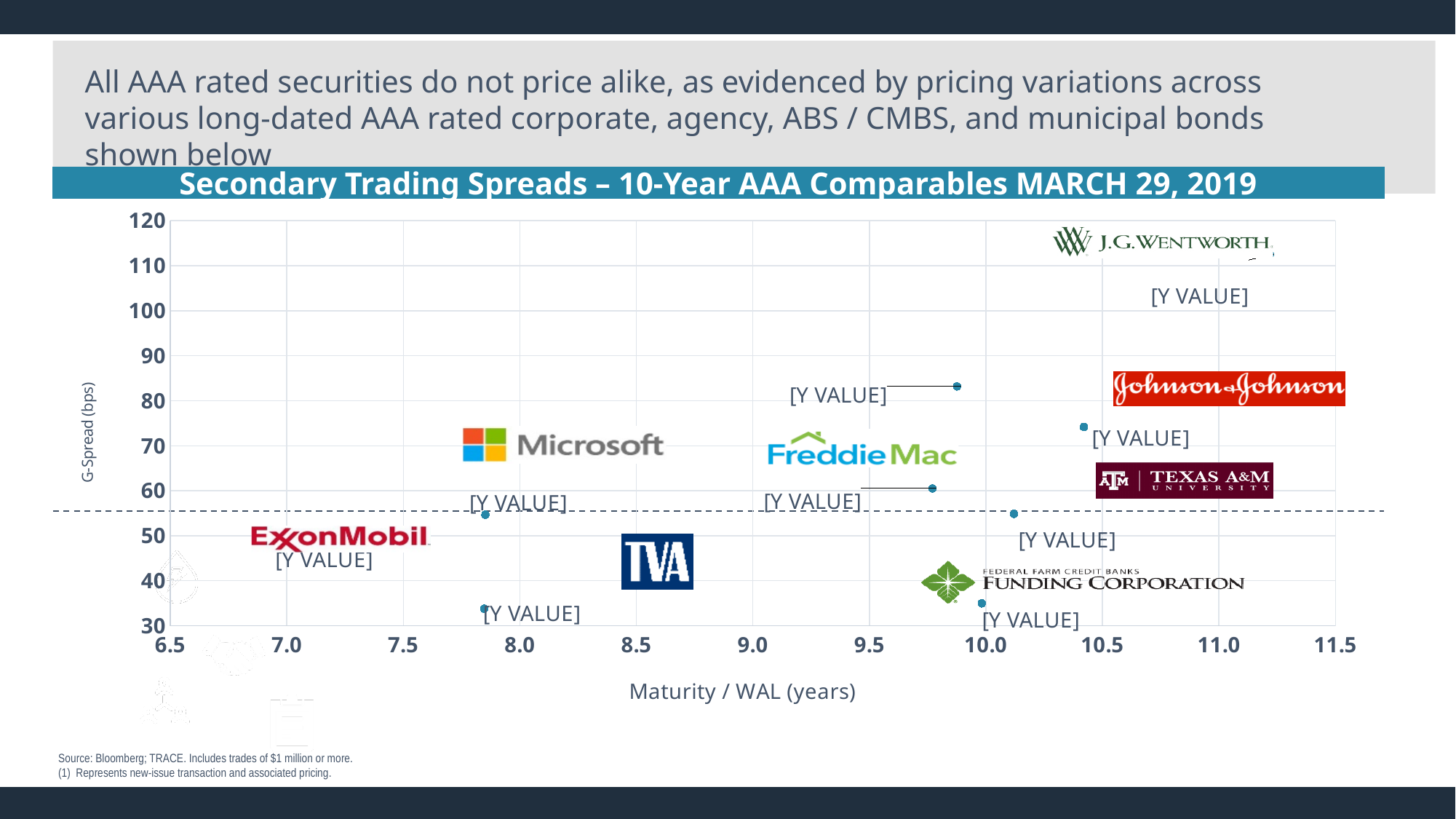
Is the G-Spread of the highest plotted point greater or less than 80? greater What kind of chart is shown on the slide? Scatter chart What is the title of the chart? Secondary Trading Spreads – 10-Year AAA Comparables MARCH 29, 2019 Is the G-Spread of the point plotted at a maturity of about 10.4 years greater or less than 70? greater What is the label of the vertical axis of the chart? G-Spread (bps) Is the G-Spread of the lowest plotted point greater or less than 40? less